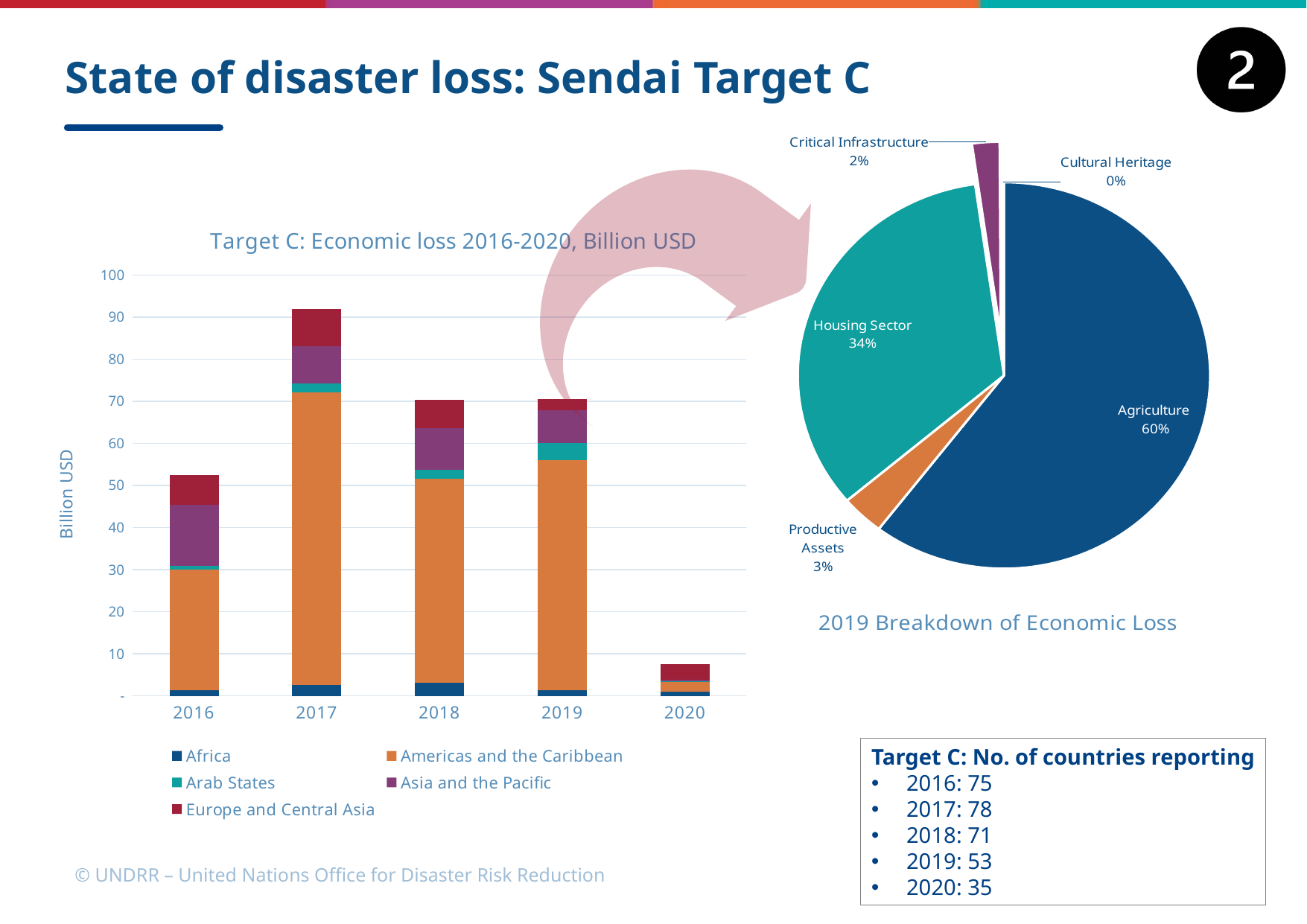
In the 'Target C: Economic loss 2016-2020, Billion USD' chart, is the total for 2016 greater or less than 60? less In the '2019 Breakdown of Economic Loss' pie chart, what share does Agriculture have? 60% In the 'Target C: Economic loss 2016-2020, Billion USD' chart, how many series does the legend list? 5 In the 'Target C: Economic loss 2016-2020, Billion USD' chart, is the total for 2020 greater or less than 10? less In the '2019 Breakdown of Economic Loss' pie chart, how many categories are shown? 5 What kind of chart is the 'Target C: Economic loss 2016-2020, Billion USD' chart? Stacked bar chart In the 'Target C: Economic loss 2016-2020, Billion USD' chart, which year has the highest total economic loss? 2017 In the 'Target C: Economic loss 2016-2020, Billion USD' chart, which year has the lowest total economic loss? 2020 In the '2019 Breakdown of Economic Loss' pie chart, what share does Housing Sector have? 34% What kind of chart is the '2019 Breakdown of Economic Loss' chart? Pie chart In the 'Target C: Economic loss 2016-2020, Billion USD' chart, is the total for 2017 greater or less than 80? greater In the 'Target C: Economic loss 2016-2020, Billion USD' chart, does the total economic loss rise or fall from 2017 to 2020? Fall